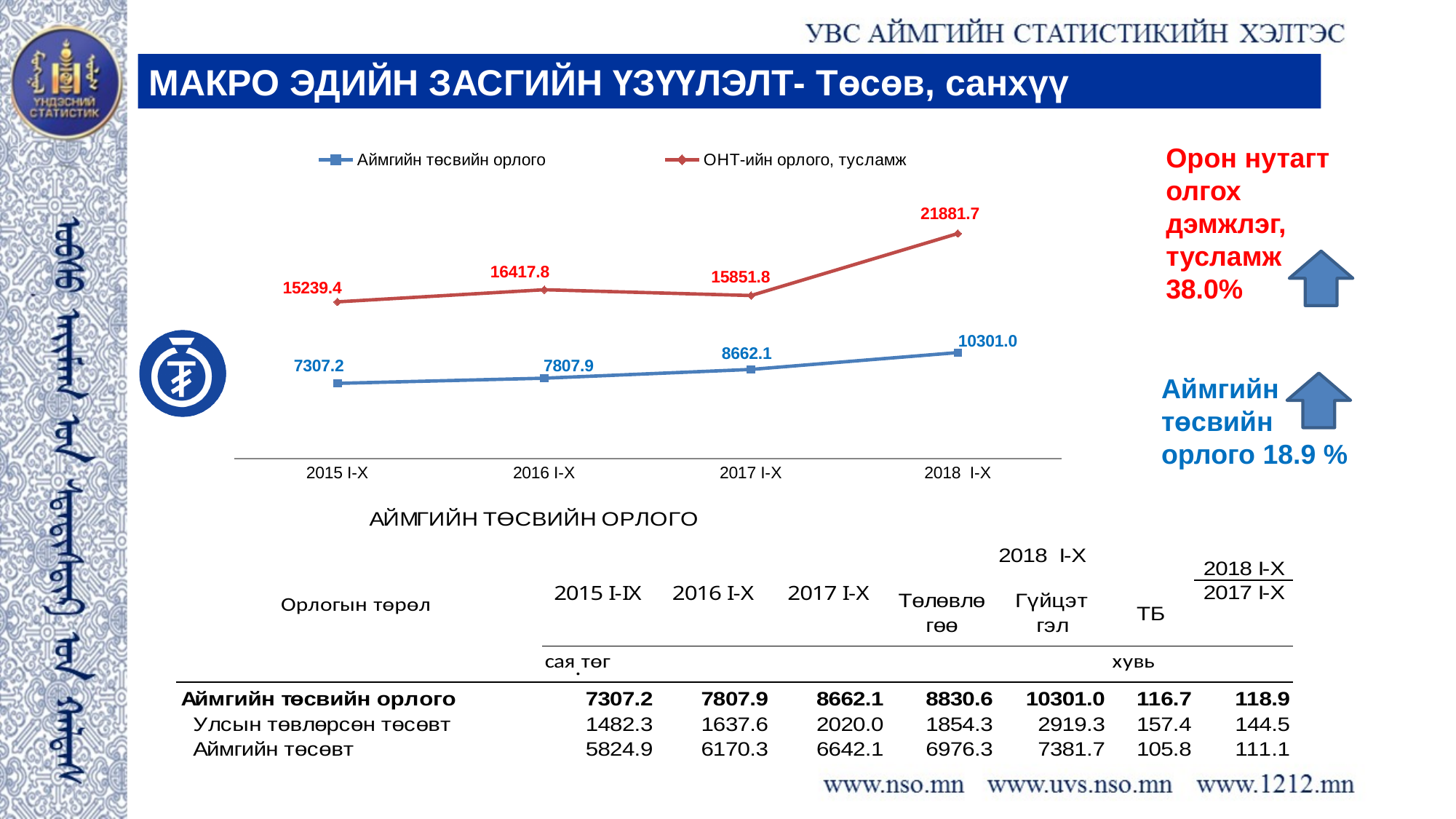
What is the value of Аймгийн төсвийн орлого for 2018 I-X? 10301.0 What is the difference between ОНТ-ийн орлого, тусламж and Аймгийн төсвийн орлого in 2018 I-X? 11580.7 How many periods are shown on the x axis of the chart? 4 What type of chart is shown on the slide? line chart Does Аймгийн төсвийн орлого rise or fall from 2015 I-X to 2018 I-X? rise What is the value of Аймгийн төсвийн орлого for 2015 I-X? 7307.2 What is the value of ОНТ-ийн орлого, тусламж for 2016 I-X? 16417.8 Which is larger in 2017 I-X: Аймгийн төсвийн орлого or ОНТ-ийн орлого, тусламж? ОНТ-ийн орлого, тусламж In which period is ОНТ-ийн орлого, тусламж highest? 2018 I-X What colour is the line for ОНТ-ийн орлого, тусламж? red In which period is ОНТ-ийн орлого, тусламж lowest? 2015 I-X How many series does the chart legend list? 2